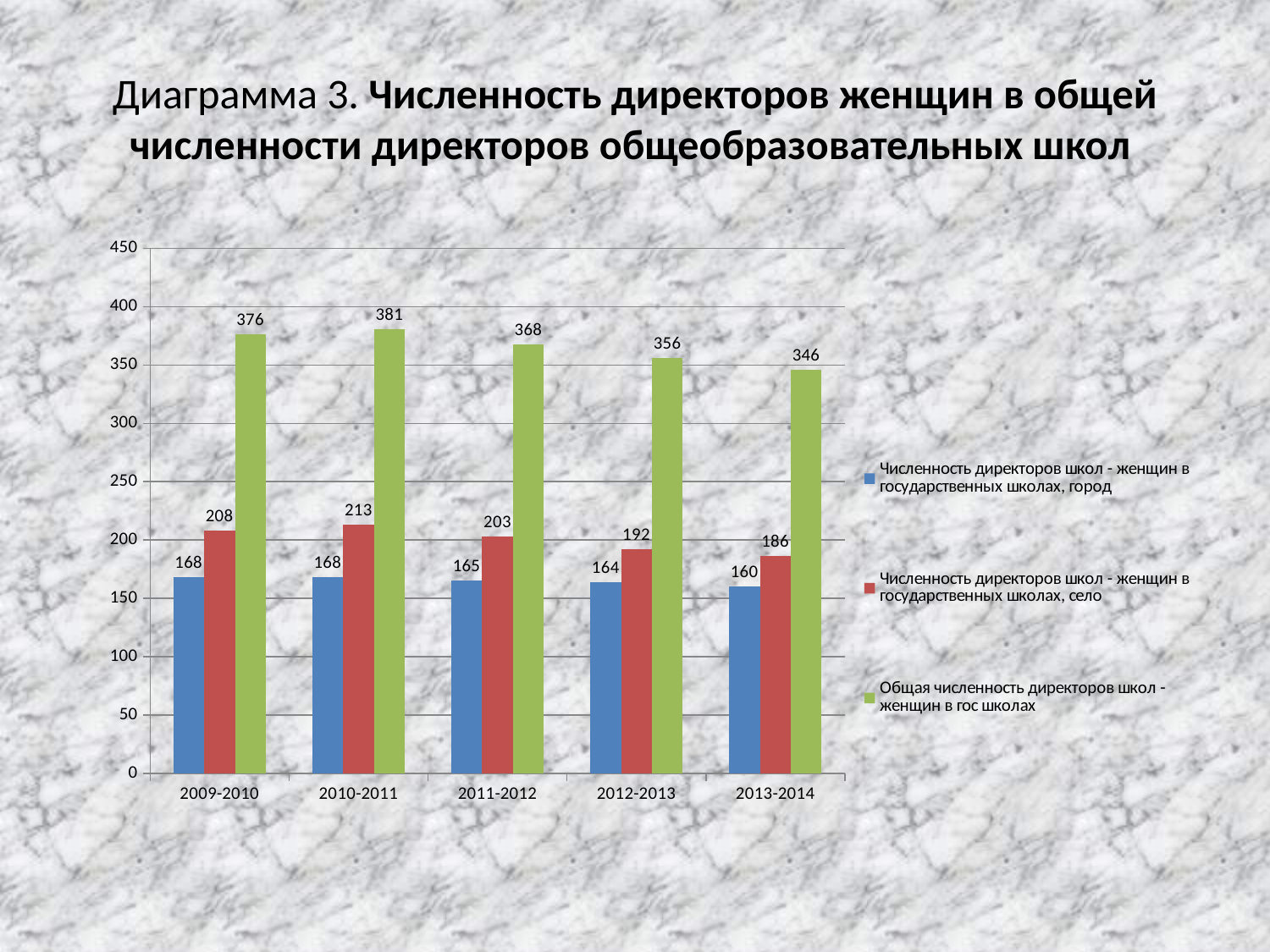
What is the value for 'Численность директоров школ - женщин в государственных школах, город' in 2011-2012? 165 What is the value for 'Численность директоров школ - женщин в государственных школах, село' in 2010-2011? 213 In which year is 'Численность директоров школ - женщин в государственных школах, город' lowest? 2013-2014 Does the 'Общая численность директоров школ - женщин в гос школах' series rise or fall from 2010-2011 to 2013-2014? fall Which is larger in 2009-2010: the 'город' value or the 'село' value? село In which year is 'Общая численность директоров школ - женщин в гос школах' highest? 2010-2011 How many year categories are shown on the x axis? 5 What is the value for 'Общая численность директоров школ - женщин в гос школах' in 2013-2014? 346 What kind of chart is shown on the slide? bar chart Is the value for 'Общая численность директоров школ - женщин в гос школах' in 2012-2013 greater or less than 300? greater What is the difference between the 'село' value and the 'город' value in 2012-2013? 28 How many series does the legend list? 3